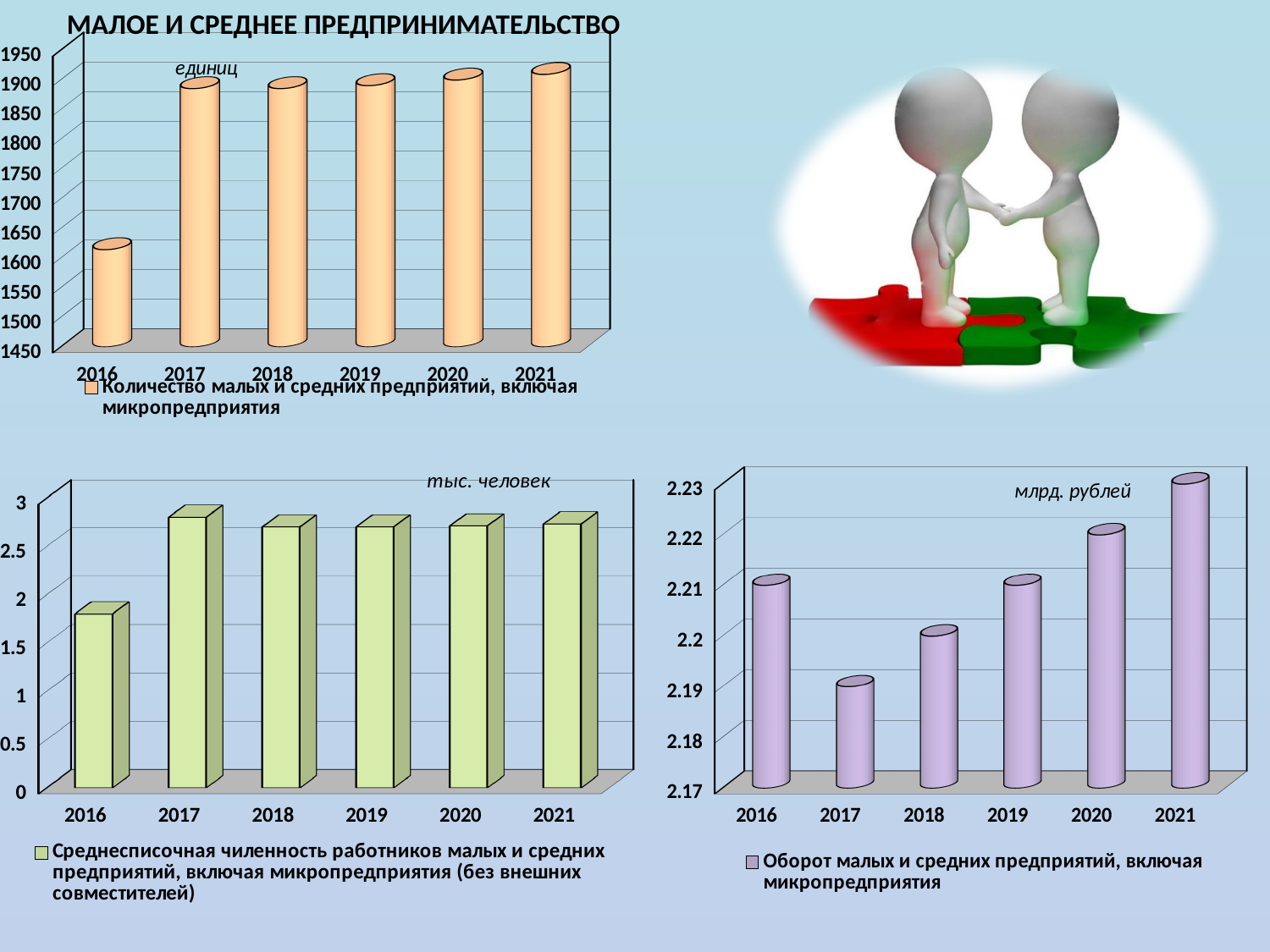
What type of chart is the top-left chart on the slide? bar chart In the bottom-right chart (млрд. рублей), which is larger, the value for 2020 or the value for 2017? 2020 How many series does the legend of the bottom-left chart list? 1 How many years are shown on the x axis of the bottom-right chart (млрд. рублей)? 6 In the top-left chart (единиц), is the value for 2017 greater or less than 1850? greater In the bottom-left chart (тыс. человек), is the value for 2016 greater or less than 2? less In the top-left chart (единиц), which year has the lowest value? 2016 In the top-left chart (единиц), is the value for 2016 greater or less than 1650? less In the bottom-left chart (тыс. человек), which year has the lowest value? 2016 In the bottom-right chart (млрд. рублей), which year has the lowest value? 2017 In the bottom-right chart (млрд. рублей), which year has the highest value? 2021